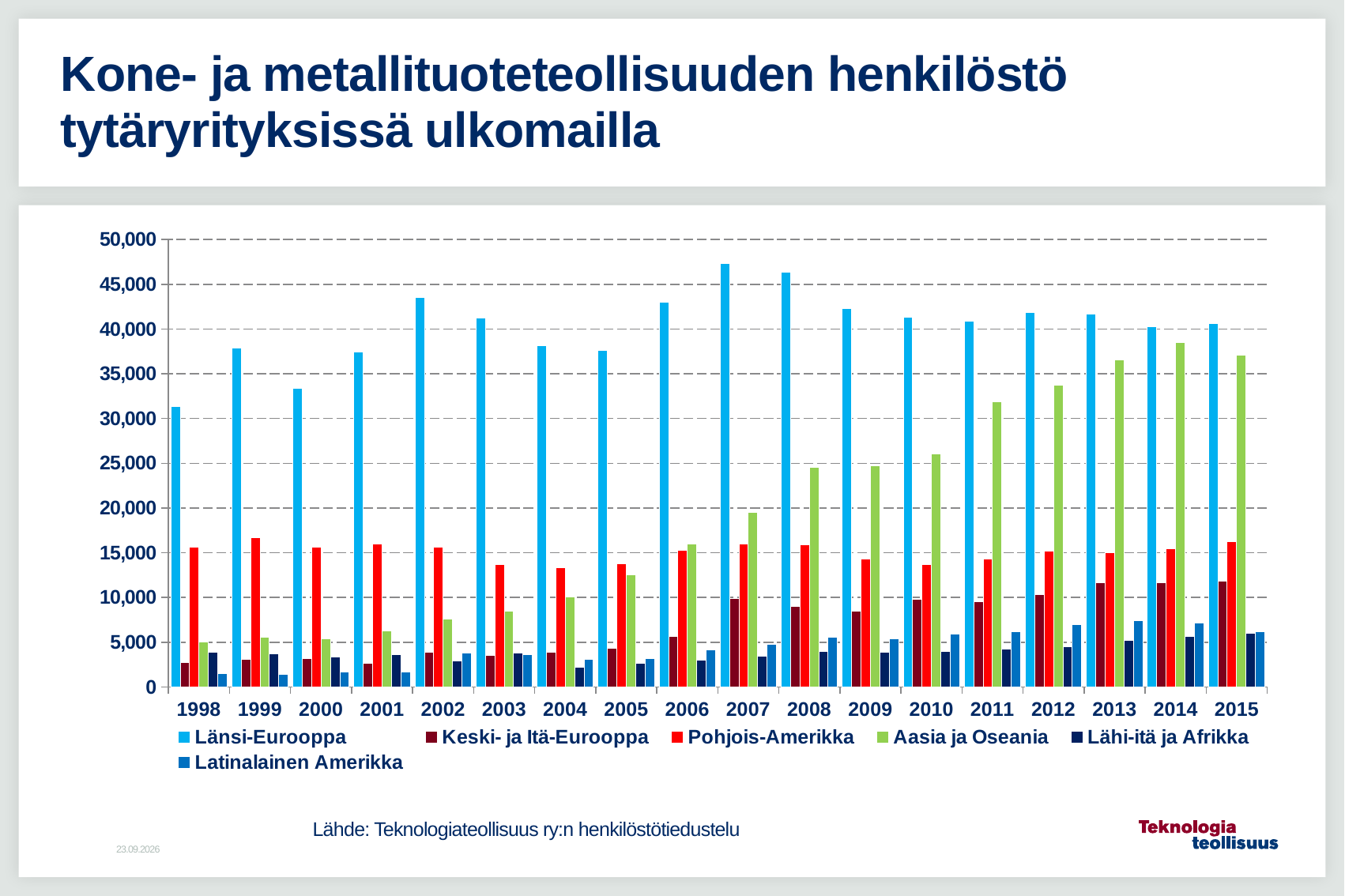
Is the value for Aasia ja Oseania in 1998 greater or less than 10,000? less Is the value for Aasia ja Oseania in 2014 greater or less than 35,000? greater Is the value for Länsi-Eurooppa in 2007 greater or less than 45,000? greater In which year is the value for Länsi-Eurooppa lowest? 1998 What kind of chart is shown on the slide? bar chart How many years are shown on the x axis? 18 In which year is the value for Länsi-Eurooppa highest? 2007 In 2015, which is larger: Länsi-Eurooppa or Aasia ja Oseania? Länsi-Eurooppa What is the source given below the chart? Teknologiateollisuus ry:n henkilöstötiedustelu Do the values for Aasia ja Oseania rise or fall from 2005 to 2014? rise How many series does the legend list? 6